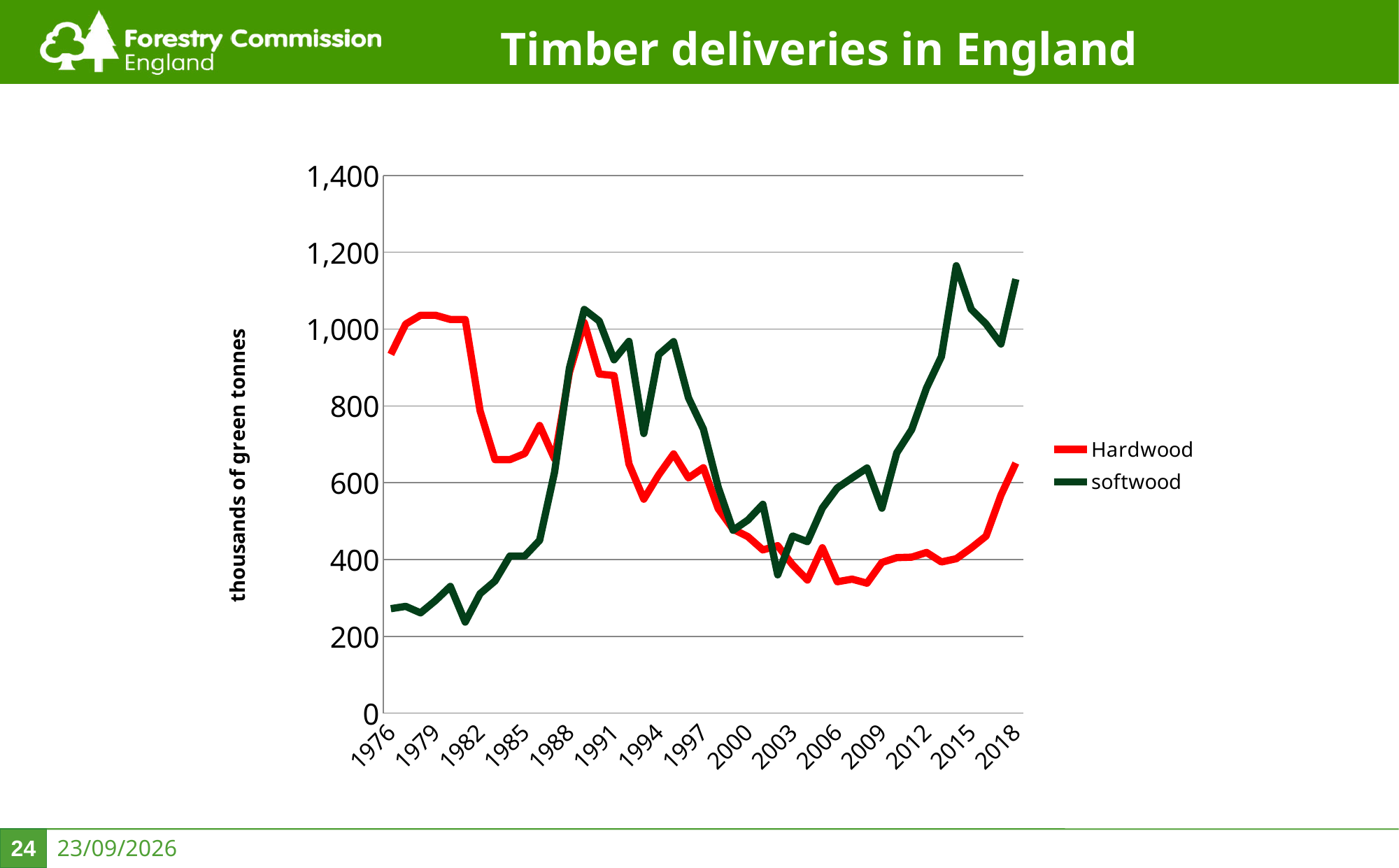
What are the two series named in the legend? Hardwood and softwood Is the softwood value for 1982 greater or less than 400? less What is the label on the vertical axis? thousands of green tonnes Is the softwood value for 1976 greater or less than 400? less Is the softwood value for 2018 greater or less than 1,000? greater Does the Hardwood line rise or fall between 1982 and 1985? fall How many series does the legend list? 2 In 1976, which series has the larger value, Hardwood or softwood? Hardwood What kind of chart is shown on the slide? line chart In 2018, which series has the larger value, Hardwood or softwood? softwood Does the softwood line rise or fall between 2009 and 2015? rise